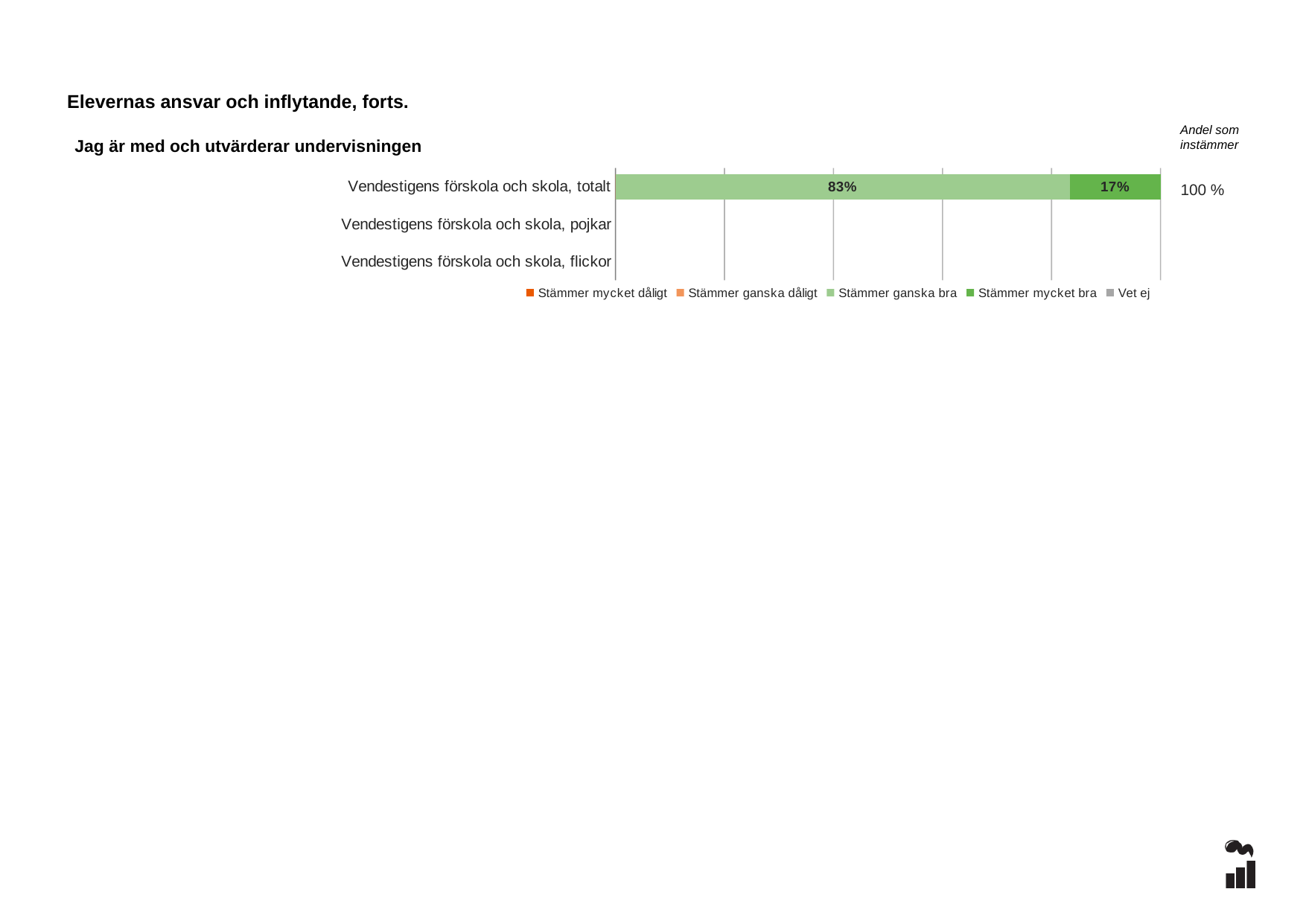
What kind of chart is shown on the slide? Stacked bar chart How many categories are listed on the vertical axis of the chart? 3 What is the value for "Stämmer ganska bra" for Vendestigens förskola och skola, totalt? 83% Which category has the largest "Stämmer ganska bra" segment? Vendestigens förskola och skola, totalt How many series does the legend list? 5 What is the "Andel som instämmer" value shown for Vendestigens förskola och skola, totalt? 100 % For Vendestigens förskola och skola, totalt, which is larger: "Stämmer ganska bra" or "Stämmer mycket bra"? Stämmer ganska bra What is the title of the chart? Jag är med och utvärderar undervisningen Which legend entry is shown in grey? Vet ej What is the difference between the "Stämmer ganska bra" and "Stämmer mycket bra" values for Vendestigens förskola och skola, totalt? 66% What is the total of the two labelled segments in the bar for Vendestigens förskola och skola, totalt? 100% What is the value for "Stämmer mycket bra" for Vendestigens förskola och skola, totalt? 17%